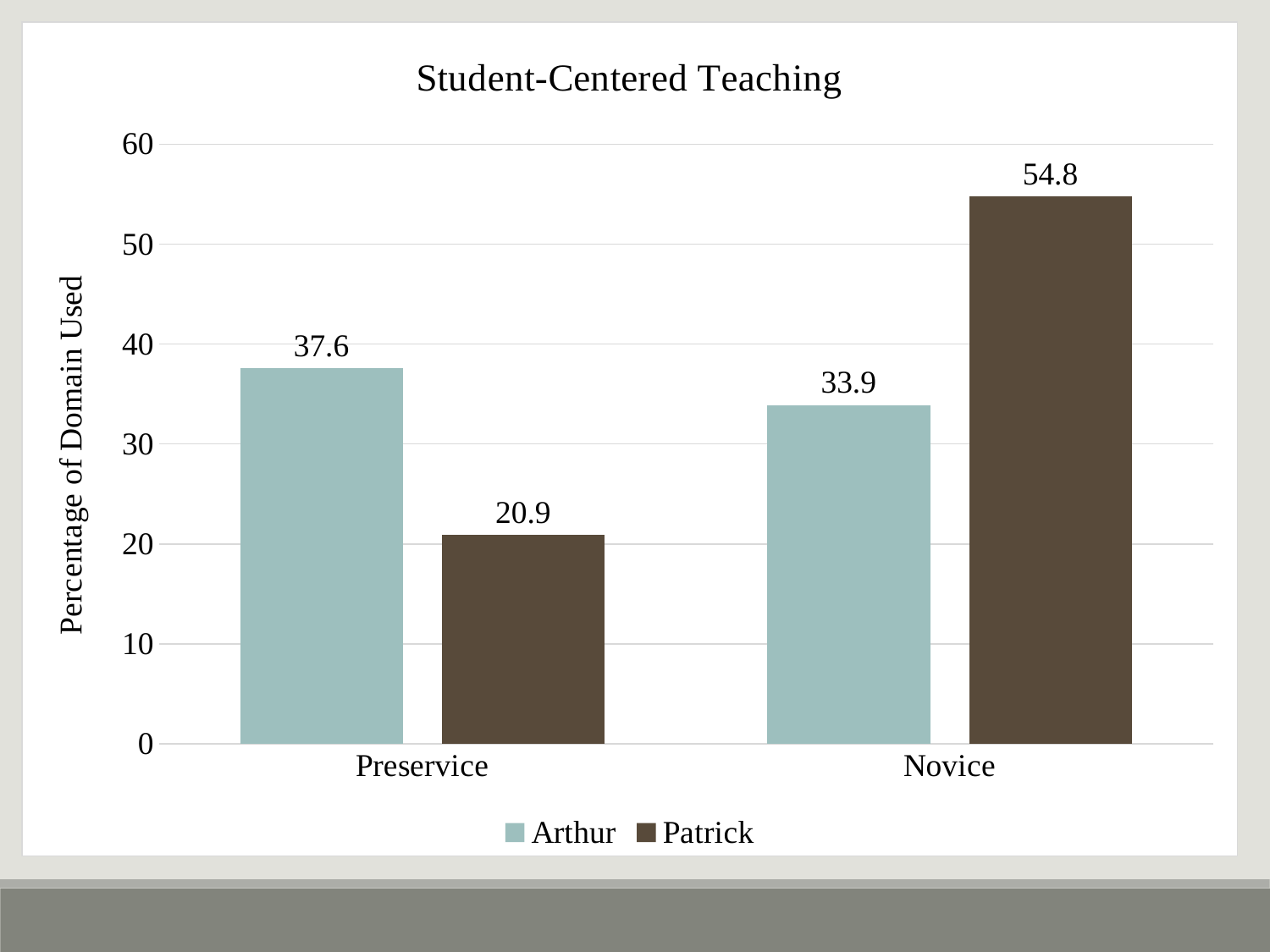
How many series does the legend list? 2 What is the value for Patrick in the Preservice category? 20.9 Which bar has the lowest value on the chart? Patrick, Preservice How many categories are shown on the x axis? 2 In the Preservice category, which is larger, Arthur or Patrick? Arthur What is the value for Arthur in the Novice category? 33.9 What is the difference between Arthur's and Patrick's values in the Preservice category? 16.7 What is the value for Patrick in the Novice category? 54.8 What is the difference between Patrick's and Arthur's values in the Novice category? 20.9 Which bar has the highest value on the chart? Patrick, Novice What kind of chart is shown on the slide? Bar chart What is the value for Arthur in the Preservice category? 37.6